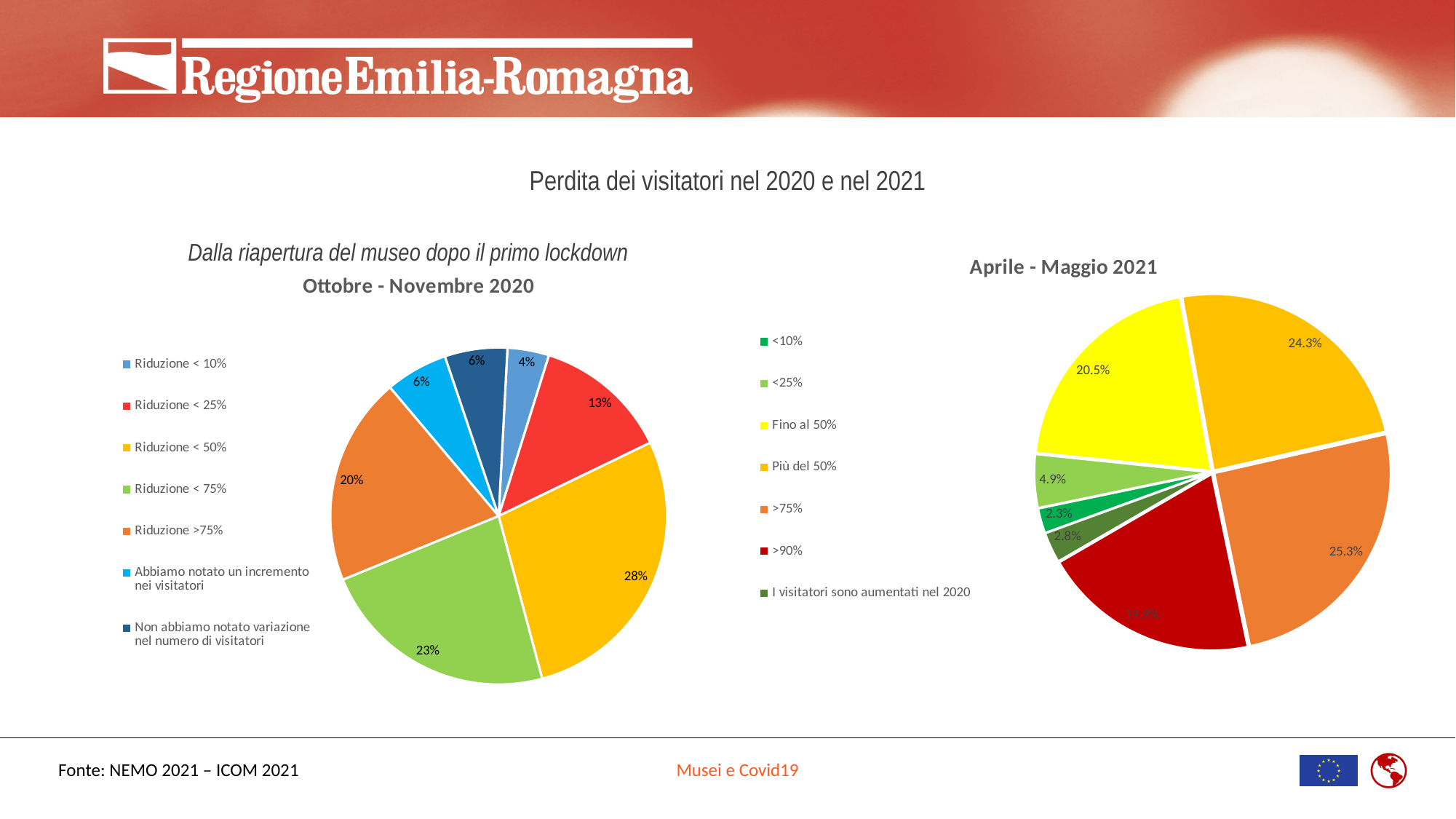
In the 'Ottobre - Novembre 2020' pie chart, what share is labelled for 'Riduzione >75%'? 20% In the 'Ottobre - Novembre 2020' pie chart, which category has the smallest slice? Riduzione < 10% In the 'Aprile - Maggio 2021' pie chart, what share is labelled for '<10%'? 2.3% In the 'Ottobre - Novembre 2020' pie chart, which category has the largest slice? Riduzione < 50% In the 'Aprile - Maggio 2021' pie chart, which is larger: the 'Più del 50%' slice or the 'Fino al 50%' slice? Più del 50% What type of chart is used for 'Aprile - Maggio 2021'? Pie chart How many categories does the legend of the 'Ottobre - Novembre 2020' pie chart list? 7 In the 'Aprile - Maggio 2021' pie chart, what is the difference between the '<25%' slice and the 'I visitatori sono aumentati nel 2020' slice? 2.1% In the 'Ottobre - Novembre 2020' pie chart, what is the difference between the 'Riduzione < 75%' slice and the 'Riduzione < 25%' slice? 10% In the 'Aprile - Maggio 2021' pie chart, what share is labelled for 'Fino al 50%'? 20.5% In the 'Ottobre - Novembre 2020' pie chart, what share is labelled for 'Riduzione < 50%'? 28% In the 'Aprile - Maggio 2021' pie chart, what share is labelled for '>75%'? 25.3%